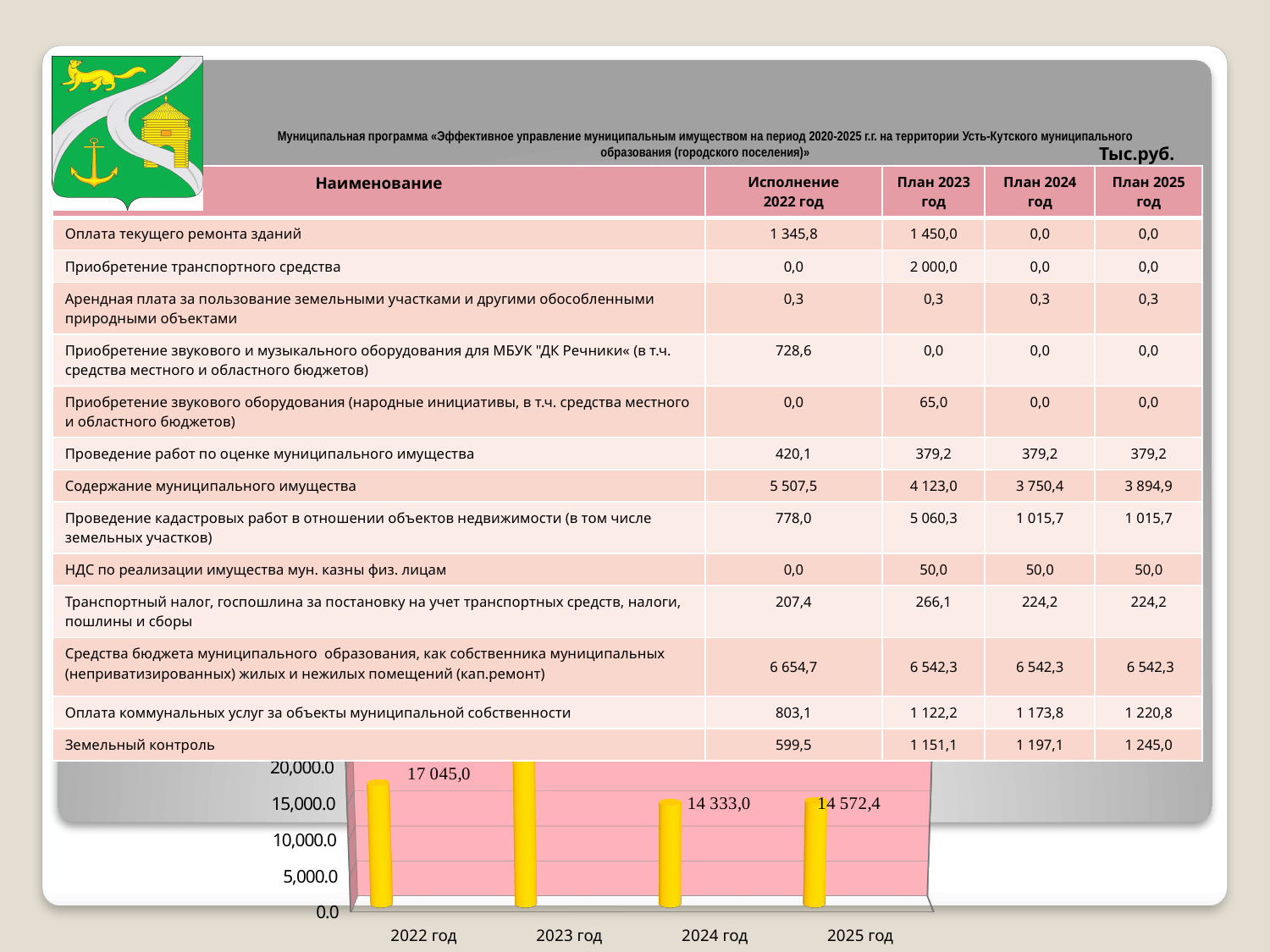
In the bar chart at the bottom of the slide, which is larger: the value for 2024 год or 2025 год? 2025 год How many bars are shown in the bar chart at the bottom of the slide? 4 What kind of chart is shown at the bottom of the slide? bar chart In the bar chart at the bottom of the slide, is the value for 2023 год greater or less than 20,000? greater In the bar chart at the bottom of the slide, what is the difference between the values for 2022 год and 2024 год? 2 712,0 In the bar chart at the bottom of the slide, is the value for 2024 год greater or less than 15,000? less In the bar chart at the bottom of the slide, what is the value for 2025 год? 14 572,4 In the bar chart at the bottom of the slide, what is the difference between the values for 2025 год and 2024 год? 239,4 In the bar chart at the bottom of the slide, which year has the lowest value? 2024 год In the bar chart at the bottom of the slide, what is the value for 2024 год? 14 333,0 In the bar chart at the bottom of the slide, which year has the tallest bar? 2023 год In the bar chart at the bottom of the slide, what is the value for 2022 год? 17 045,0